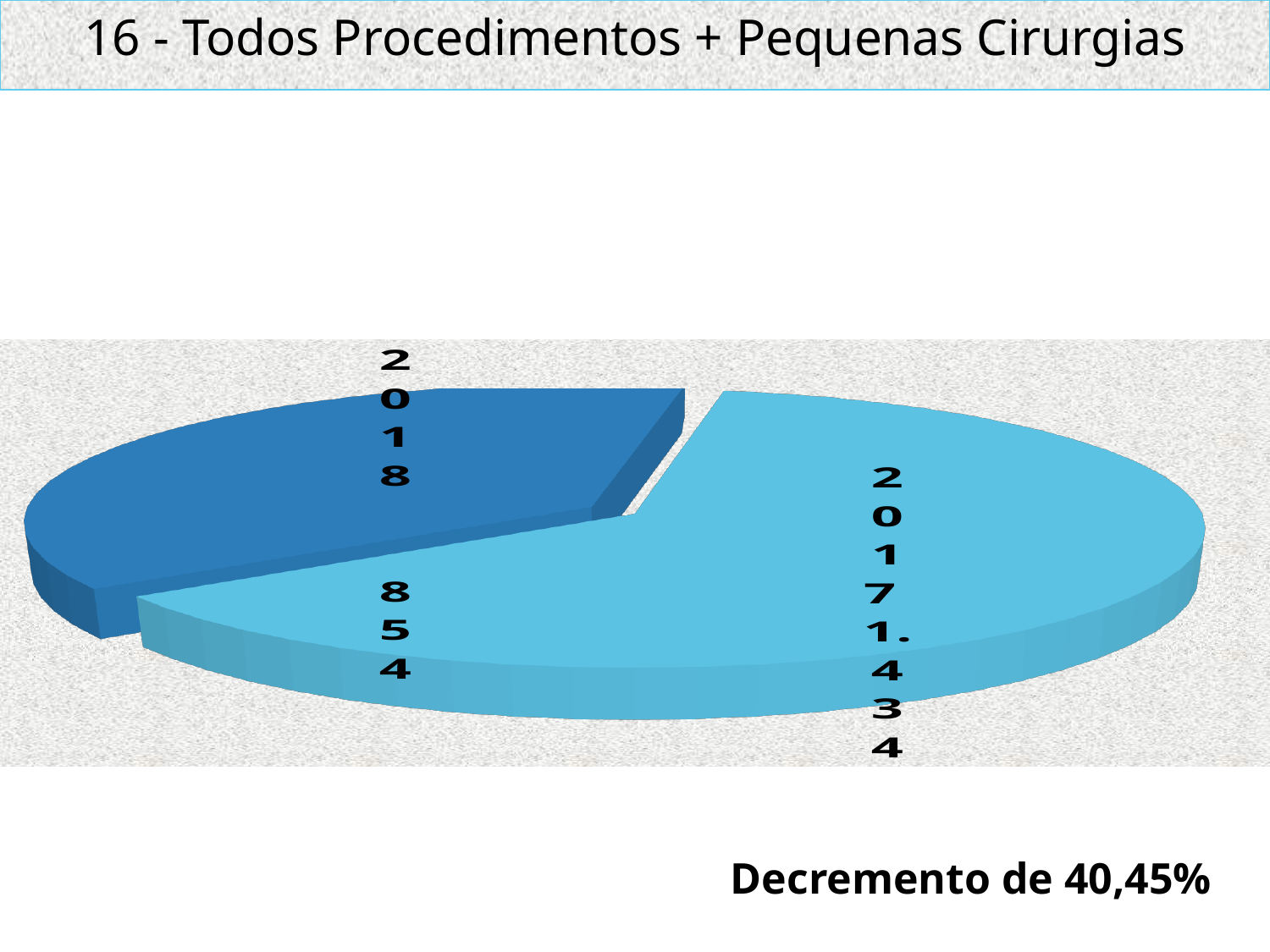
What is the difference between the 2017 value and the 2018 value? 580 What is the value shown for 2017 in the pie chart? 1.434 Is the value for 2017 larger or smaller than the value for 2018? larger Which year has the larger slice in the pie chart? 2017 What is the value shown for 2018 in the pie chart? 854 How many slices does the pie chart have? 2 What percentage decrease is stated in the text below the chart? 40,45% What kind of chart is shown on the slide? pie chart What is the title of the slide containing the pie chart? 16 - Todos Procedimentos + Pequenas Cirurgias Which year has the smaller slice in the pie chart? 2018